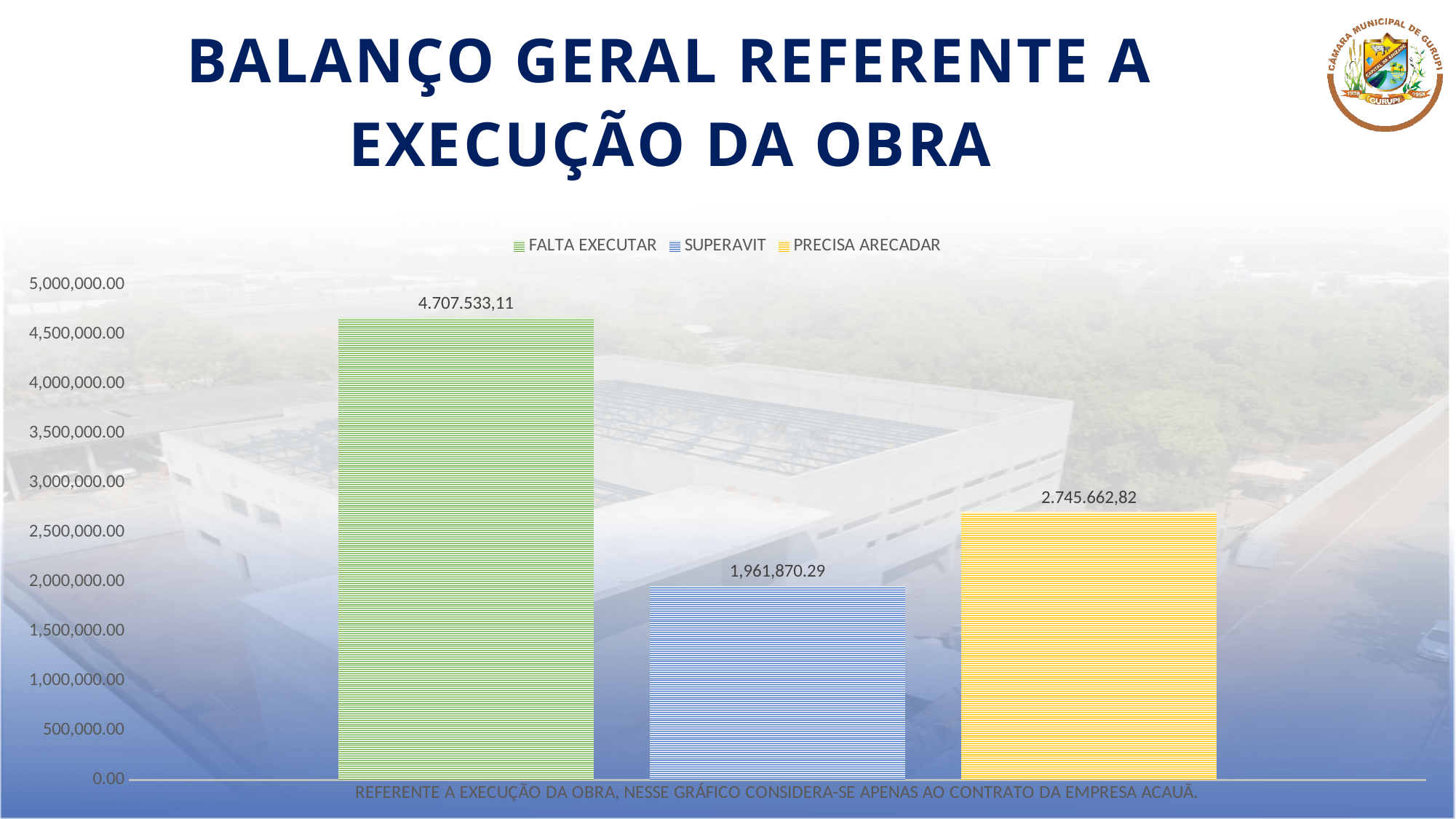
Which series has the highest value? FALTA EXECUTAR What is the value shown for FALTA EXECUTAR? 4.707.533,11 What is the value shown for PRECISA ARECADAR? 2.745.662,82 How many bars are plotted in the chart? 3 Which colour represents PRECISA ARECADAR in the legend? yellow Which is larger, PRECISA ARECADAR or SUPERAVIT? PRECISA ARECADAR Is the value for SUPERAVIT greater or less than 2,000,000.00? less How many series does the legend list? 3 What kind of chart is shown on the slide? bar chart What is the value shown for SUPERAVIT? 1,961,870.29 Is the value for FALTA EXECUTAR greater or less than 4,500,000.00? greater Which series has the lowest value? SUPERAVIT